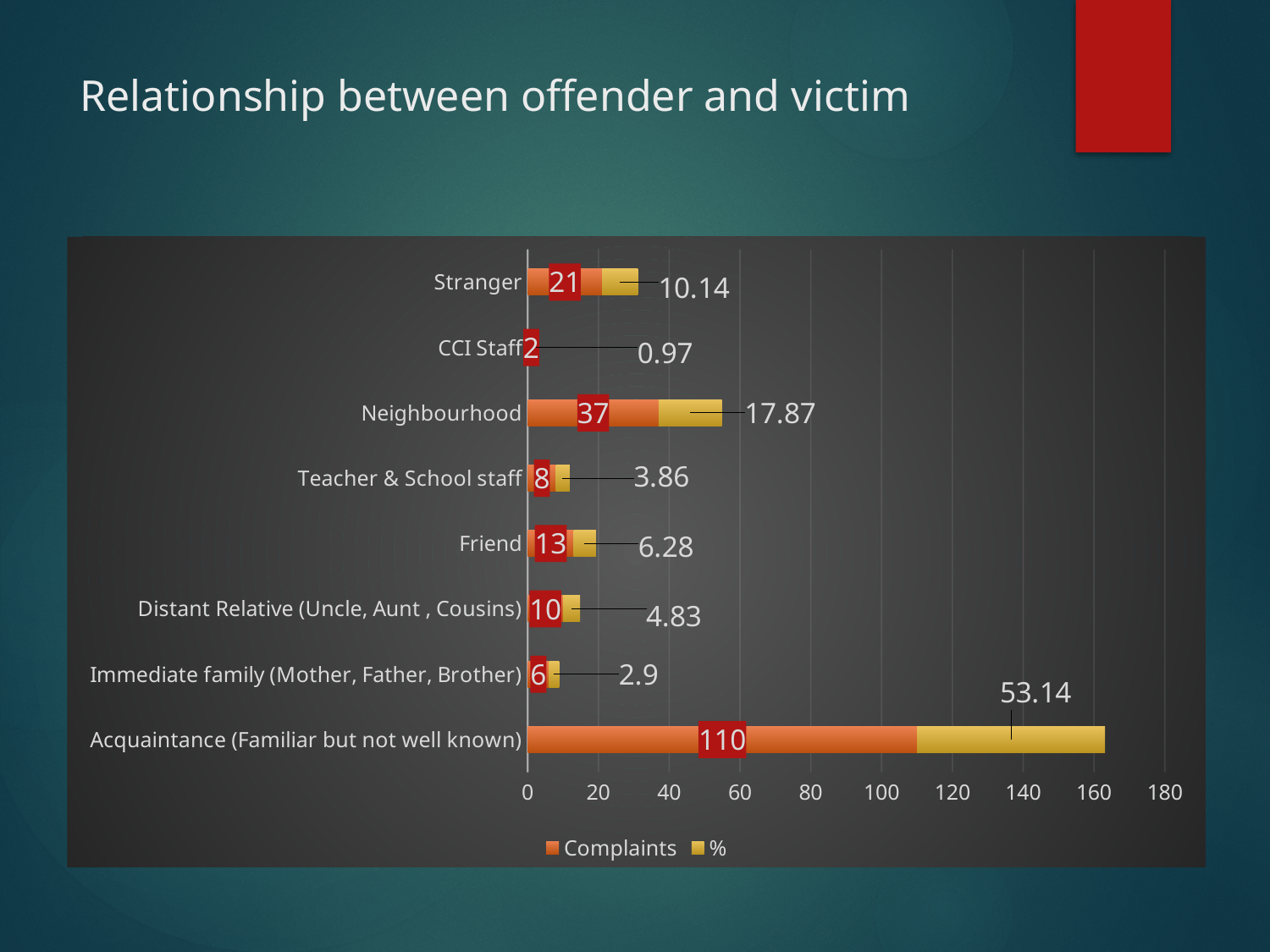
Which has more Complaints, Friend or Distant Relative (Uncle, Aunt , Cousins)? Friend How many categories are shown on the chart? 8 How many series does the legend list? 2 What is the number of Complaints for Neighbourhood? 37 Which category has the lowest number of Complaints? CCI Staff What is the number of Complaints for Acquaintance (Familiar but not well known)? 110 What is the % value for Teacher & School staff? 3.86 Which category has the highest number of Complaints? Acquaintance (Familiar but not well known) What is the % value for Stranger? 10.14 What is the total of the stacked bar for Immediate family (Mother, Father, Brother)? 8.9 What kind of chart is shown on the slide? Stacked bar chart What is the difference in Complaints between Neighbourhood and Stranger? 16